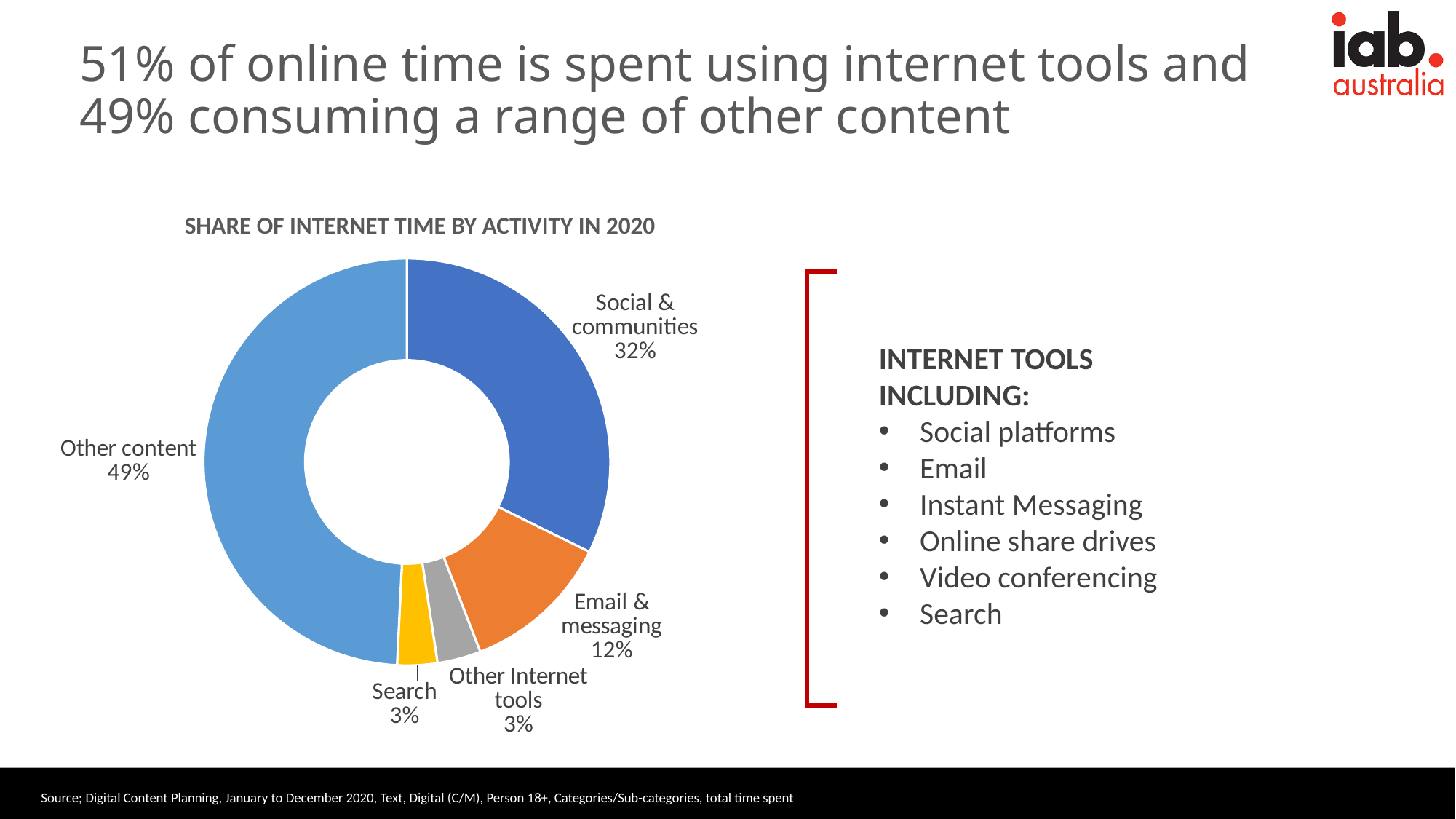
How many activity categories are shown in the chart? 5 Which activity has a larger share: Social & communities or Email & messaging? Social & communities What share of internet time is spent on Search? 3% What share of internet time is spent on Email & messaging? 12% What kind of chart is used to show share of internet time by activity? Doughnut (pie) chart What share of internet time is spent on Social & communities? 32% What colour is the Search slice in the chart? Yellow What is the difference in share between Social & communities and Email & messaging? 20% What is the title of the chart? SHARE OF INTERNET TIME BY ACTIVITY IN 2020 Which activity has the largest share of internet time? Other content What is the difference in share between Other content and Social & communities? 17% What share of internet time is spent on Other content? 49%